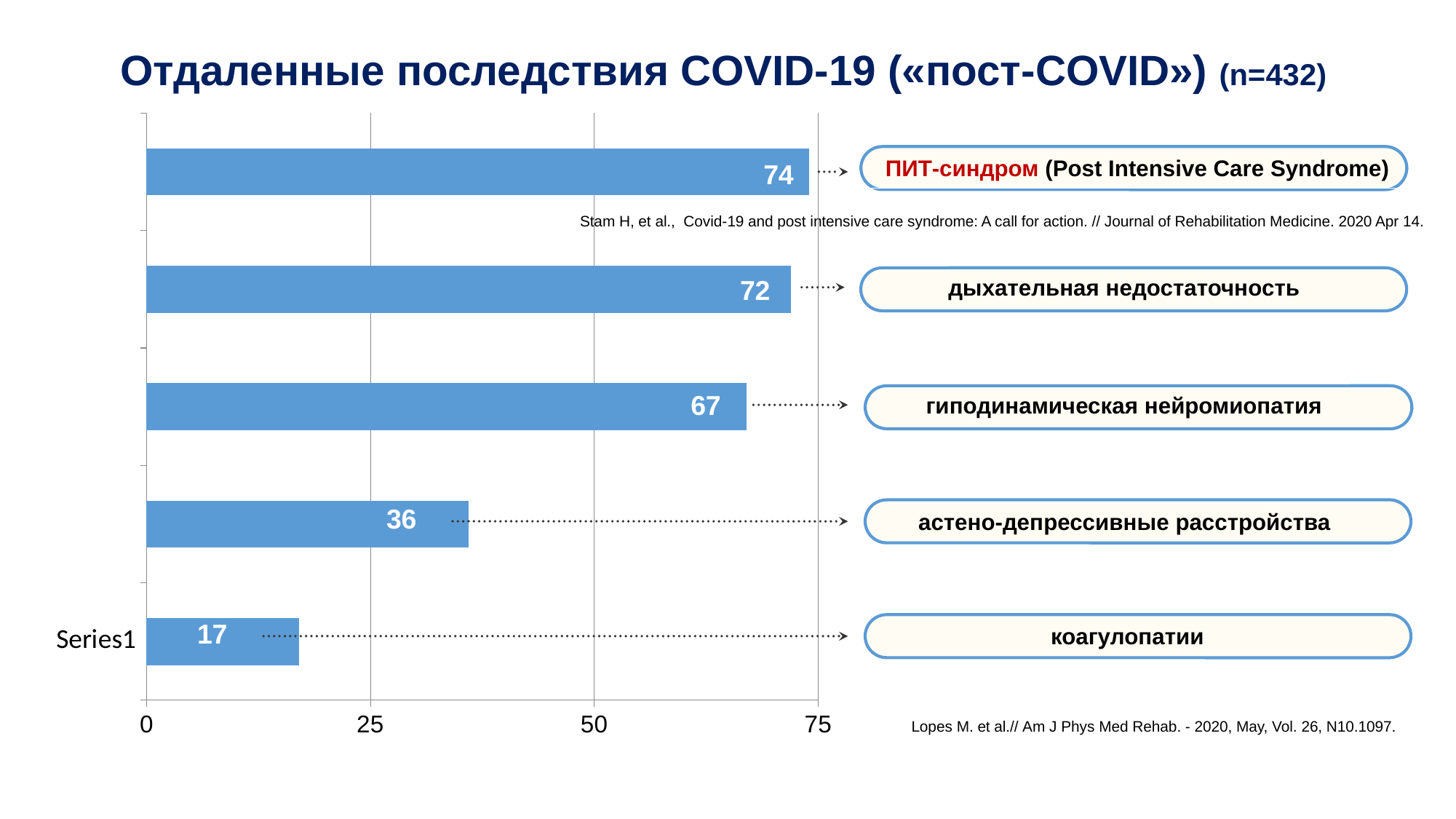
Is the value for астено-депрессивные расстройства greater or less than 50? less What type of chart is shown on the slide? bar chart What is the value of the bar for ПИТ-синдром (Post Intensive Care Syndrome)? 74 Which category has the lowest value in the chart? коагулопатии What is the value of the bar for коагулопатии? 17 What is the value of the bar for дыхательная недостаточность? 72 What is the value of the bar for астено-депрессивные расстройства? 36 What is the value of the bar for гиподинамическая нейромиопатия? 67 How many bars are plotted in the chart? 5 What is the difference between the values for ПИТ-синдром and коагулопатии? 57 Which category has the highest value in the chart? ПИТ-синдром (Post Intensive Care Syndrome) Which is larger: the value for гиподинамическая нейромиопатия or the value for астено-депрессивные расстройства? гиподинамическая нейромиопатия